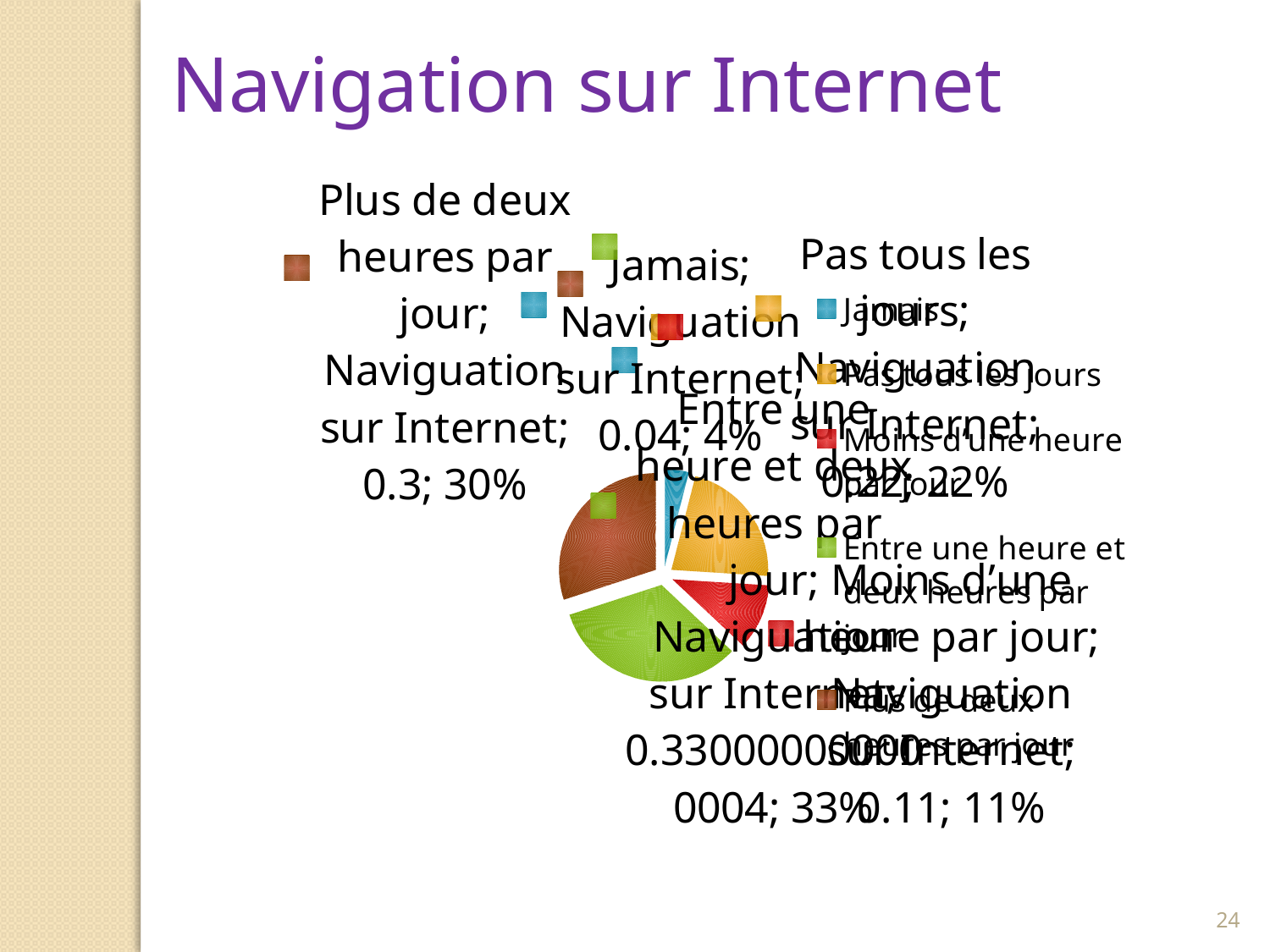
How many categories does the pie chart have? 5 Which colour is used for the "Jamais" slice in the legend? blue What share of the pie does "Jamais" represent? 4% Which category has the largest slice of the pie? Entre une heure et deux heures par jour What is the difference in percentage points between "Plus de deux heures par jour" and "Jamais"? 26 Which category has the smallest slice of the pie? Jamais What share of the pie does "Moins d'une heure par jour" represent? 11% What is the title of the chart on the slide? Navigation sur Internet What kind of chart is shown on the slide? pie chart What share of the pie does "Plus de deux heures par jour" represent? 30% Which is larger: the share for "Plus de deux heures par jour" or the share for "Moins d'une heure par jour"? Plus de deux heures par jour